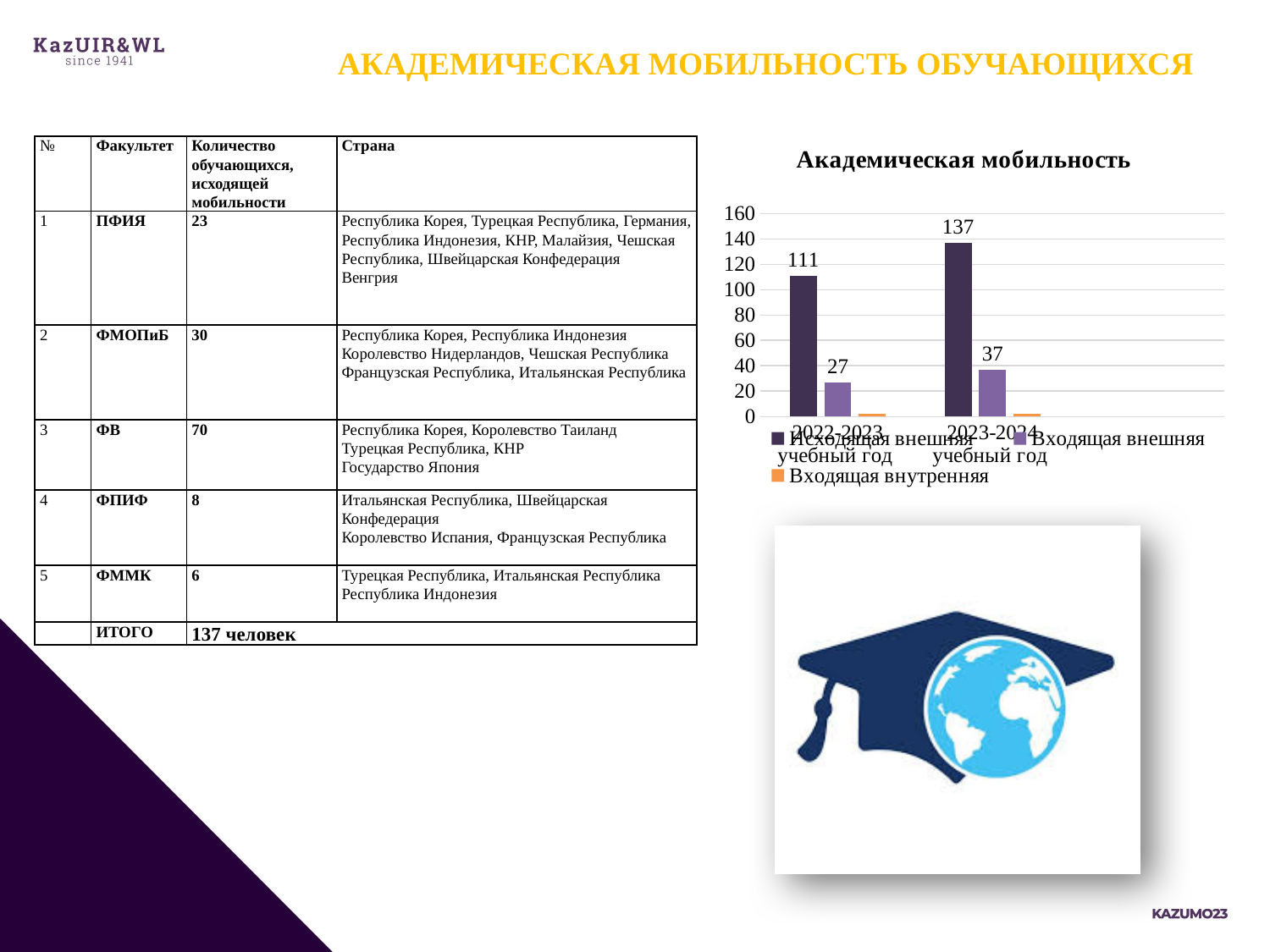
What is the difference between Входящая внешняя in 2023-2024 and 2022-2023 учебный год? 10 What is the value of Исходящая внешняя for 2022-2023 учебный год? 111 How many series does the chart legend list? 3 Which series has the highest value in 2023-2024 учебный год? Исходящая внешняя How many academic years are shown on the x axis of the chart? 2 Is the value for Входящая внутренняя in 2022-2023 учебный год greater or less than 20? less By how much did Исходящая внешняя increase from 2022-2023 to 2023-2024 учебный год? 26 What is the value of Входящая внешняя for 2023-2024 учебный год? 37 What is the value of Исходящая внешняя for 2023-2024 учебный год? 137 What type of chart is used to show Академическая мобильность? bar chart Which year has the higher value for Исходящая внешняя, 2022-2023 or 2023-2024 учебный год? 2023-2024 учебный год What is the value of Входящая внешняя for 2022-2023 учебный год? 27